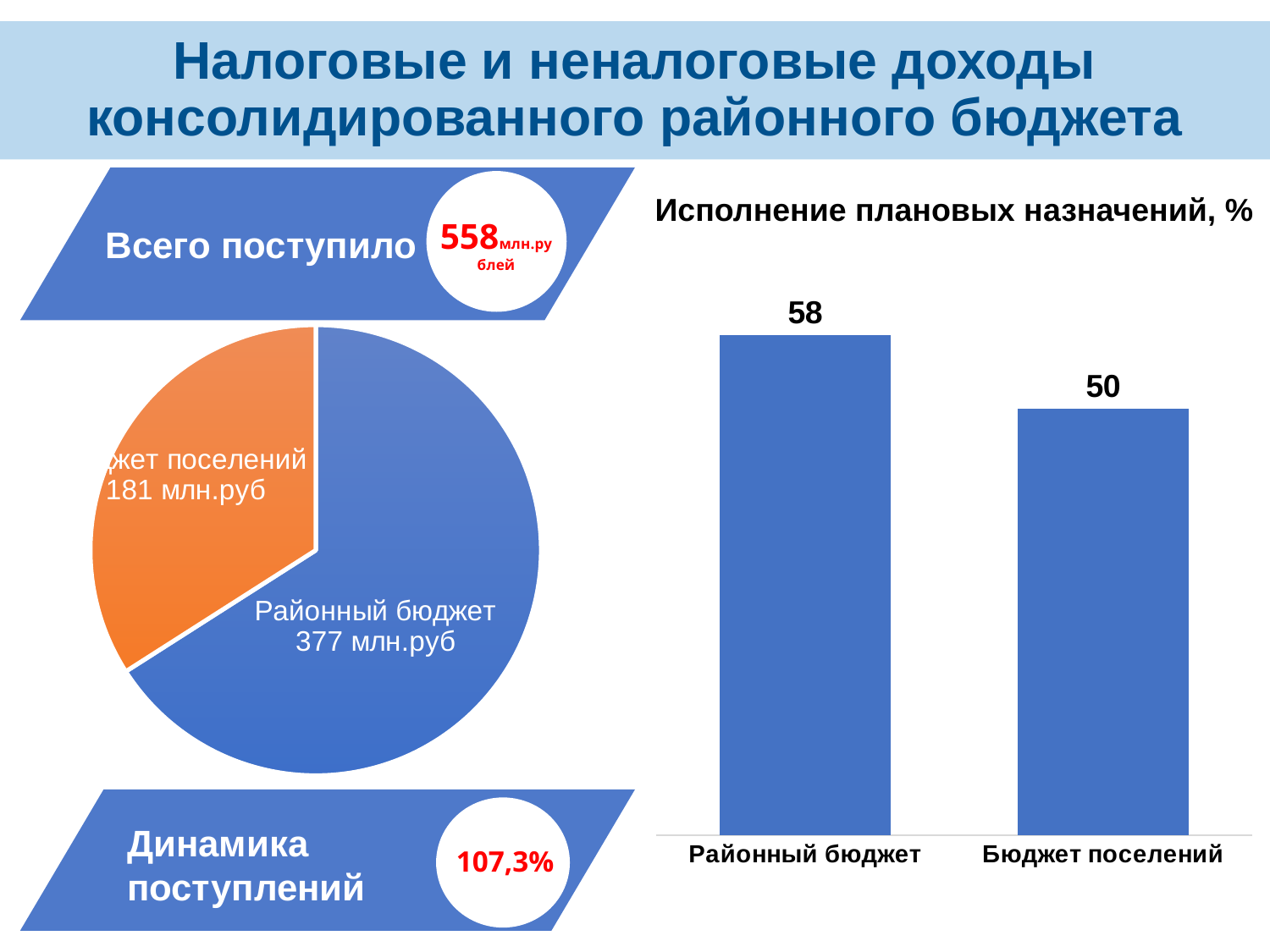
In the bar chart titled 'Исполнение плановых назначений, %', which category has the lowest value? Бюджет поселений In the bar chart titled 'Исполнение плановых назначений, %', how many categories are shown? 2 In the pie chart on the left, what is the difference between Районный бюджет and Бюджет поселений? 196 млн.руб In the bar chart titled 'Исполнение плановых назначений, %', what is the value for Бюджет поселений? 50 What kind of chart is the chart on the left side of the slide? Pie chart In the pie chart on the left, what is the value for Бюджет поселений? 181 млн.руб In the bar chart titled 'Исполнение плановых назначений, %', what is the value for Районный бюджет? 58 In the bar chart titled 'Исполнение плановых назначений, %', which category has the highest value? Районный бюджет In the bar chart titled 'Исполнение плановых назначений, %', what is the difference between the values for Районный бюджет and Бюджет поселений? 8 In the pie chart on the left, which slice is larger: Районный бюджет or Бюджет поселений? Районный бюджет What kind of chart is the chart on the right side of the slide? Bar chart In the pie chart on the left, what is the value for Районный бюджет? 377 млн.руб